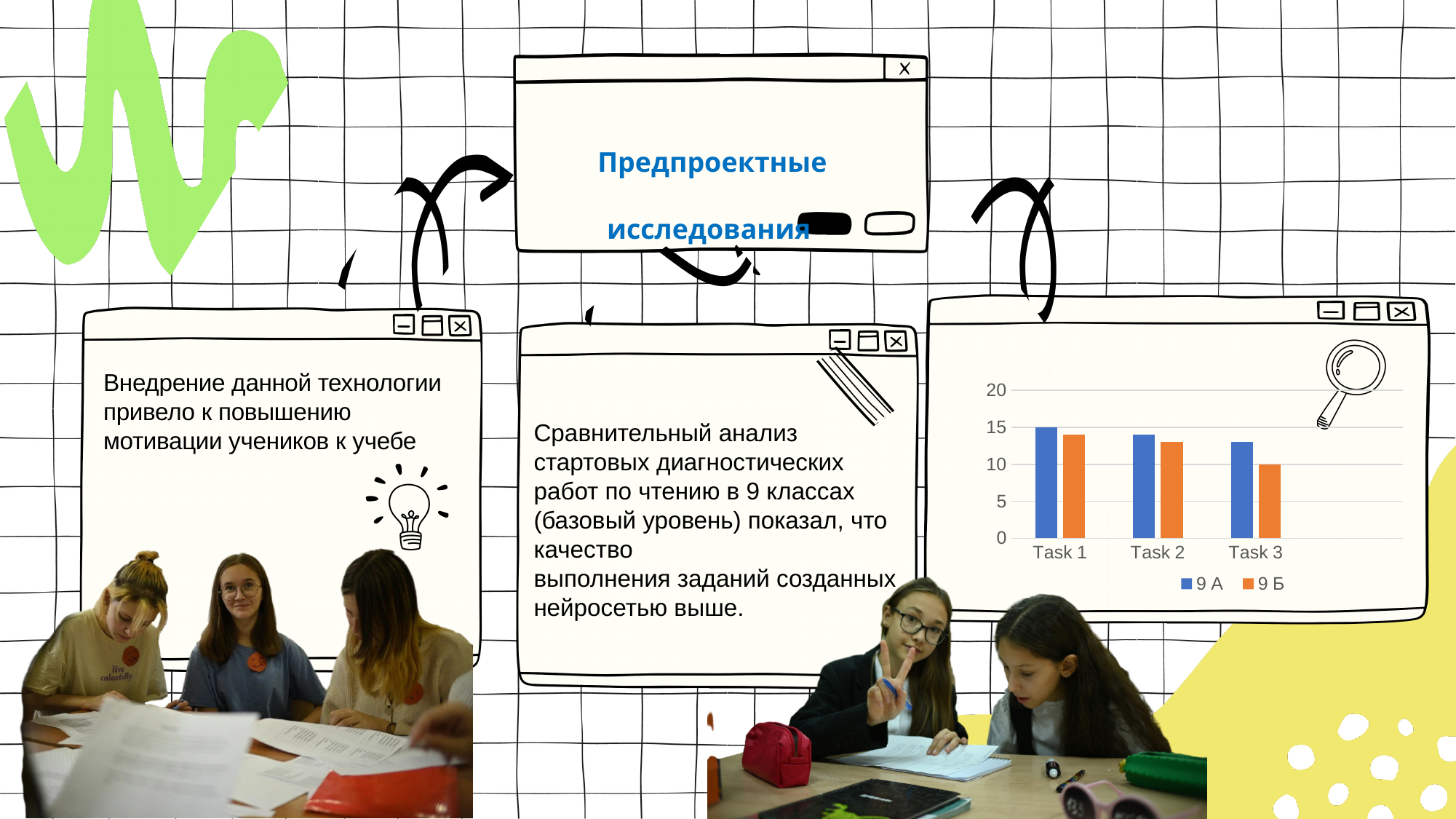
Is the value for 9 А in Task 2 greater or less than 15? less Is the value for 9 Б in Task 1 greater or less than 15? less How many series does the chart's legend list? 2 For which task is the 9 Б value lowest? Task 3 How many task categories are shown on the x axis of the chart? 3 Do the 9 А values rise or fall from Task 1 to Task 3? fall Is the value for 9 А in Task 3 greater or less than 10? greater What kind of chart is shown on the slide? bar chart What is the difference between the 9 А value in Task 1 and the 9 Б value in Task 3? 5 In Task 3, which series has the larger value, 9 А or 9 Б? 9 А What is the value for 9 Б in Task 3? 10 What is the value for 9 А in Task 1? 15